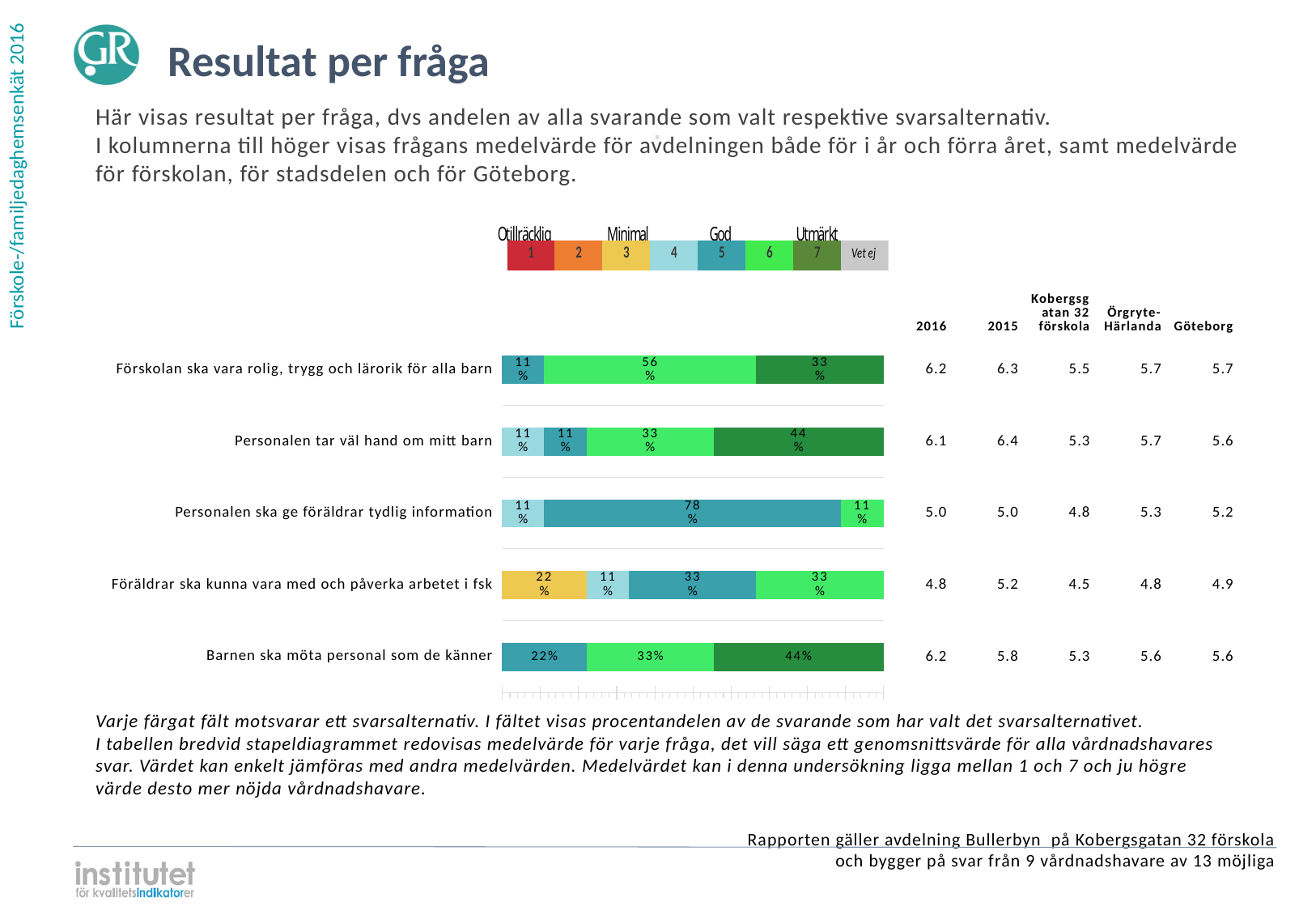
What is the largest segment in the bar for "Personalen ska ge föräldrar tydlig information"? 78% How many answer options are shown in the colour legend above the chart, including "Vet ej"? 8 What percentage of respondents chose answer option 6 (light green) for "Förskolan ska vara rolig, trygg och lärorik för alla barn"? 56% Which is larger for "Barnen ska möta personal som de känner": the share choosing option 6 (light green) or option 7 (dark green)? Option 7 (44%) Which label in the legend corresponds to answer option 7? Utmärkt How many questions (categories) are plotted in the bar chart? 5 How many segments make up the bar for "Föräldrar ska kunna vara med och påverka arbetet i fsk"? 4 What is the difference between the 56% segment and the 33% segment in the bar for "Förskolan ska vara rolig, trygg och lärorik för alla barn"? 23 percentage points What percentage of respondents chose answer option 7 (dark green) for "Personalen tar väl hand om mitt barn"? 44% What kind of chart is shown on the slide? Stacked bar chart What percentage of respondents chose answer option 3 (yellow) for "Föräldrar ska kunna vara med och påverka arbetet i fsk"? 22% What percentage of respondents chose answer option 5 (teal) for "Barnen ska möta personal som de känner"? 22%